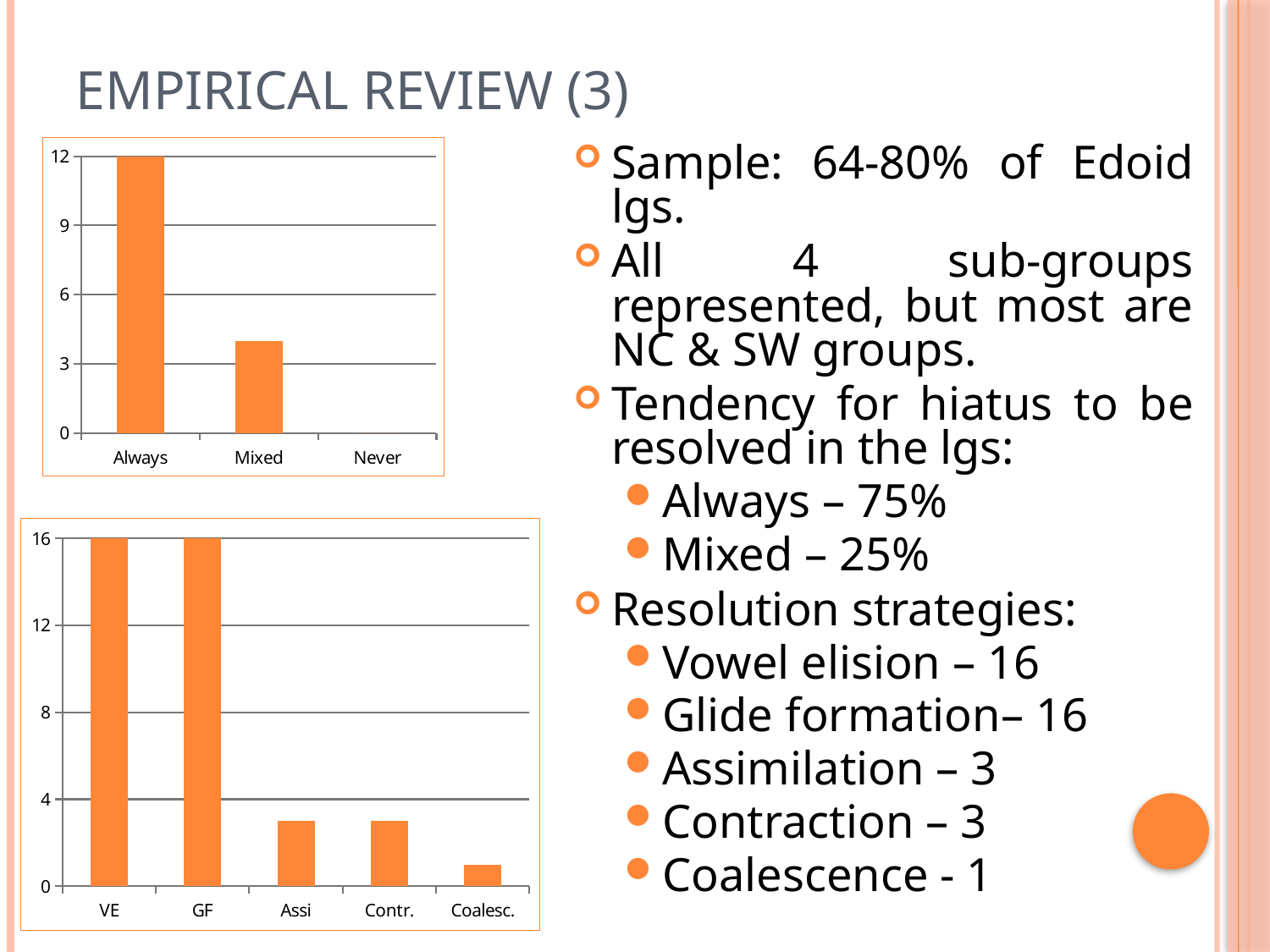
In the top chart, is the value for Mixed greater or less than 6? less In the bottom chart, how many categories are shown on the x axis? 5 In the top chart, what is the difference between the values for Always and Never? 12 In the bottom chart, which category has the lowest value? Coalesc. In the top chart, how many categories are shown on the x axis? 3 In the bottom chart, what is the value for VE? 16 In the bottom chart, is the value for Assi greater or less than 4? less In the top chart, which category has the highest value? Always In the bottom chart, which is larger, the value for Contr. or the value for Coalesc.? Contr. In the top chart, what is the value for Never? 0 In the top chart, what is the value for Always? 12 What type of chart is the top chart on the slide? bar chart